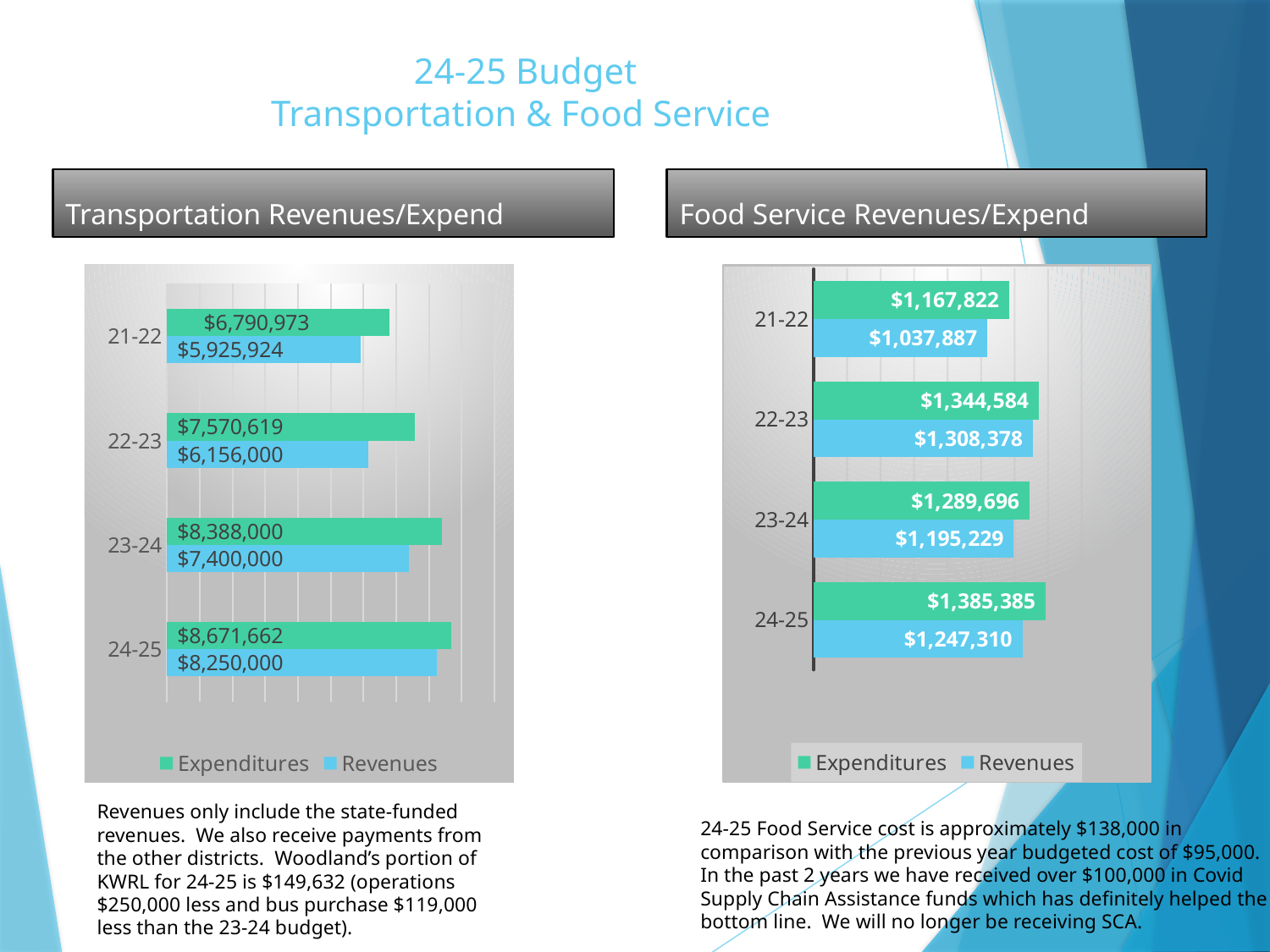
In the Food Service Revenues/Expend chart, which is larger for 23-24: Expenditures or Revenues? Expenditures In the Transportation Revenues/Expend chart, what are the Expenditures for 24-25? $8,671,662 What kind of chart is the Transportation Revenues/Expend chart? Bar chart How many years are shown in the Transportation Revenues/Expend chart? 4 How many series does the legend of the Food Service Revenues/Expend chart list? 2 In the Transportation Revenues/Expend chart, which year has the lowest Revenues? 21-22 In the Food Service Revenues/Expend chart, what are the Revenues for 23-24? $1,195,229 In the Food Service Revenues/Expend chart, which year has the highest Expenditures? 24-25 In the Food Service Revenues/Expend chart, what are the Expenditures for 22-23? $1,344,584 In the Transportation Revenues/Expend chart, what are the Revenues for 22-23? $6,156,000 In the Transportation Revenues/Expend chart, what is the difference between Expenditures and Revenues for 24-25? $421,662 In the Food Service Revenues/Expend chart, what is the difference between Expenditures and Revenues for 21-22? $129,935